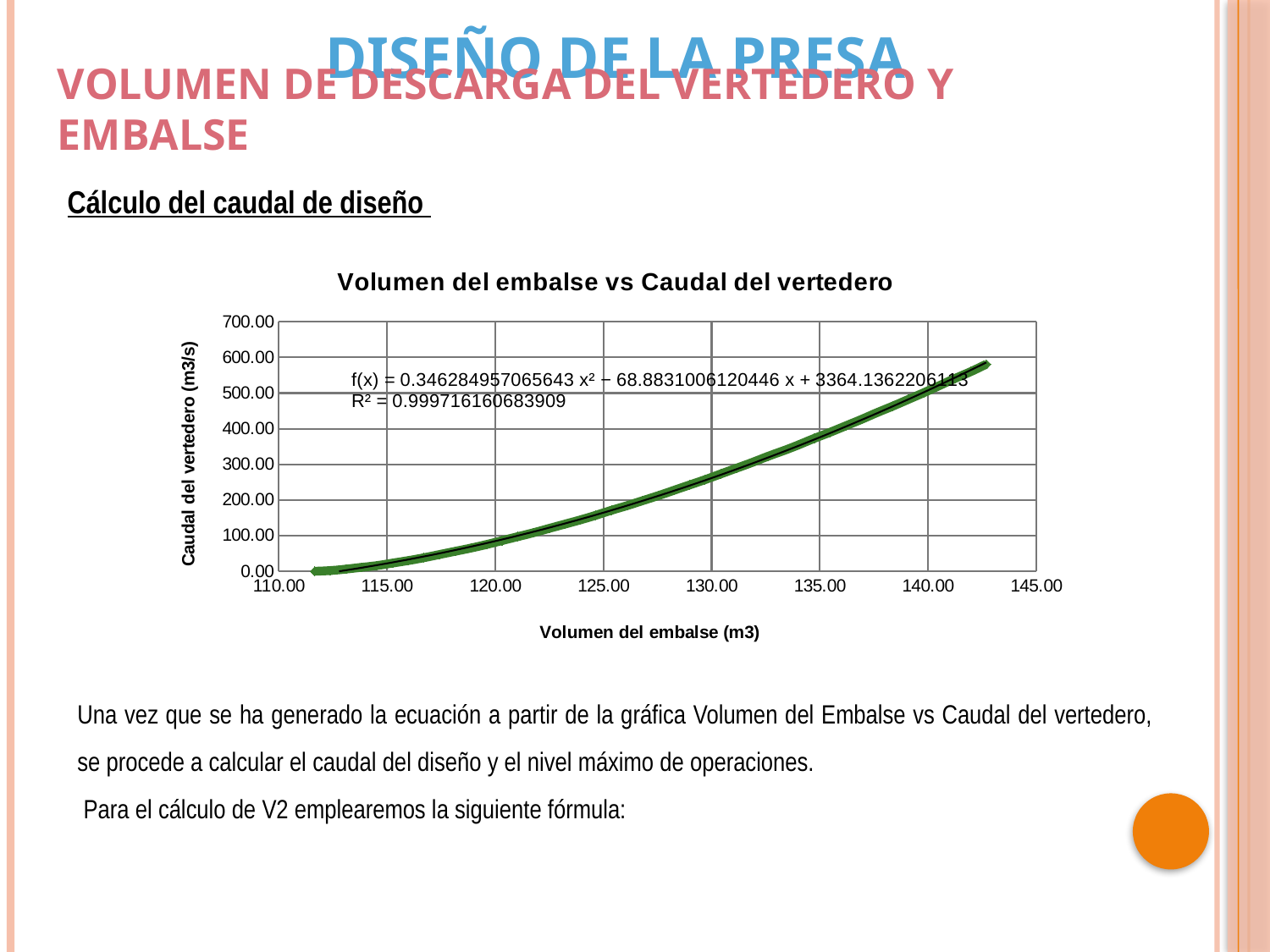
What is the lowest value shown on the horizontal axis of the chart? 110.00 What is the label of the vertical axis of the chart? Caudal del vertedero (m3/s) Is the Caudal del vertedero at a Volumen del embalse of 125.00 greater or less than 100.00? greater What kind of chart is shown on the slide? Line chart (scatter with trendline) What is the title of the chart? Volumen del embalse vs Caudal del vertedero Is the Caudal del vertedero at a Volumen del embalse of 140.00 greater or less than 400.00? greater Does the Caudal del vertedero rise or fall as the Volumen del embalse increases along the x axis? Rise How many tick labels are shown on the horizontal axis of the chart? 8 Is the Caudal del vertedero at a Volumen del embalse of 130.00 greater or less than 300.00? less What R² value is printed on the chart for the trendline? R² = 0.999716160683909 What is the highest value shown on the vertical axis of the chart? 700.00